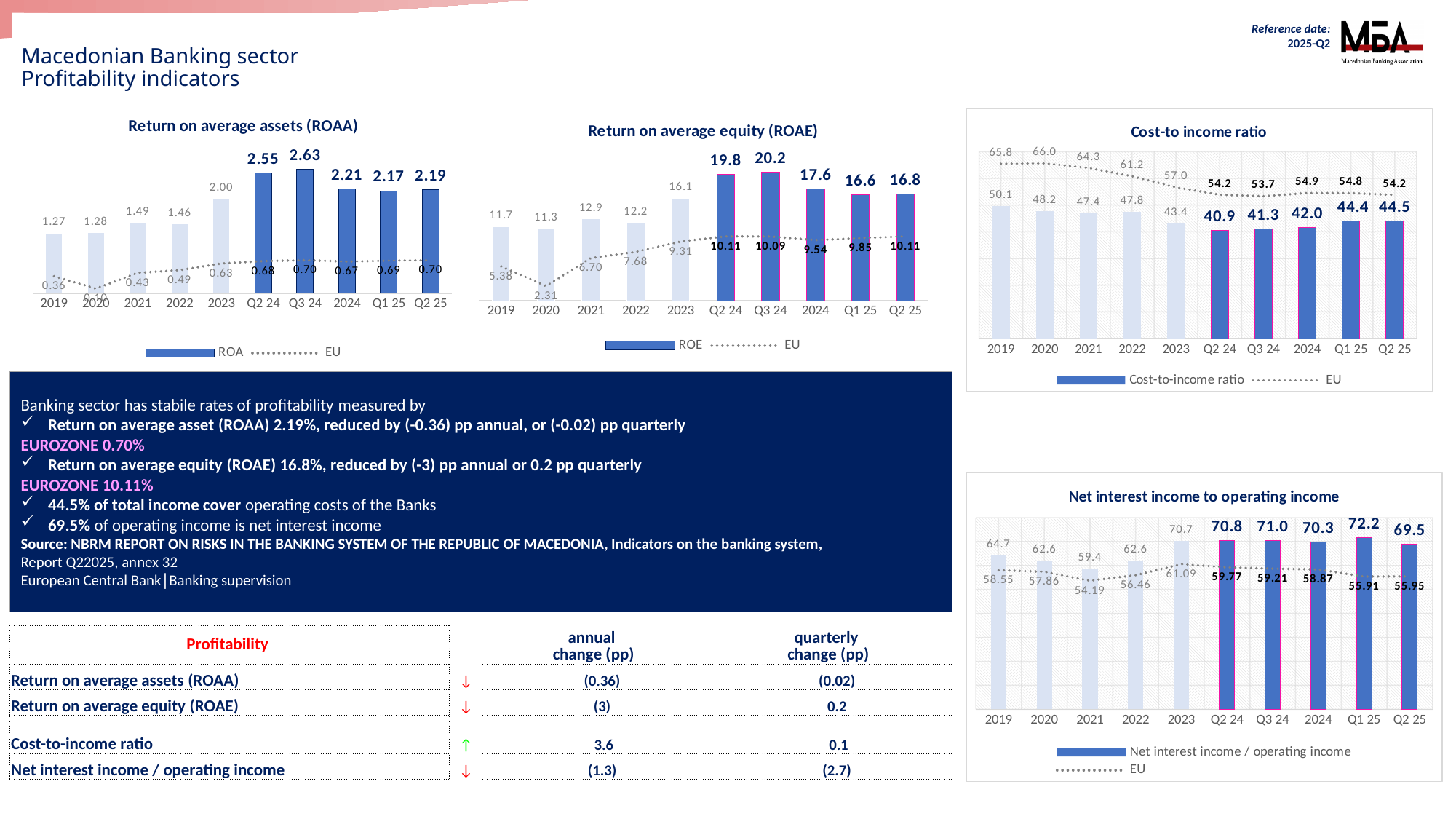
In the Net interest income to operating income chart, which period has the highest bar? Q1 25 In the Cost-to income ratio chart, does the EU line rise or fall from 2019 to 2023? fall In the Return on average equity (ROAE) chart, which is larger, the ROE for Q2 24 or for Q3 24? Q3 24 In the Return on average assets (ROAA) chart, which period has the highest ROA bar? Q3 24 In the Cost-to income ratio chart, what is the difference between the cost-to-income ratio for 2019 and for Q2 25? 5.6 In the Net interest income to operating income chart, what is the EU value for Q2 25? 55.95 How many periods are shown on the x axis of the Return on average assets (ROAA) chart? 10 In the Return on average equity (ROAE) chart, which period has the lowest ROE bar? 2020 In the Return on average assets (ROAA) chart, what is the ROA value for Q2 25? 2.19 In the Cost-to income ratio chart, which period has the lowest cost-to-income ratio bar? Q2 24 In the Return on average equity (ROAE) chart, what is the EU value for 2020? 2.31 How many series does the legend of the Return on average assets (ROAA) chart list? 2